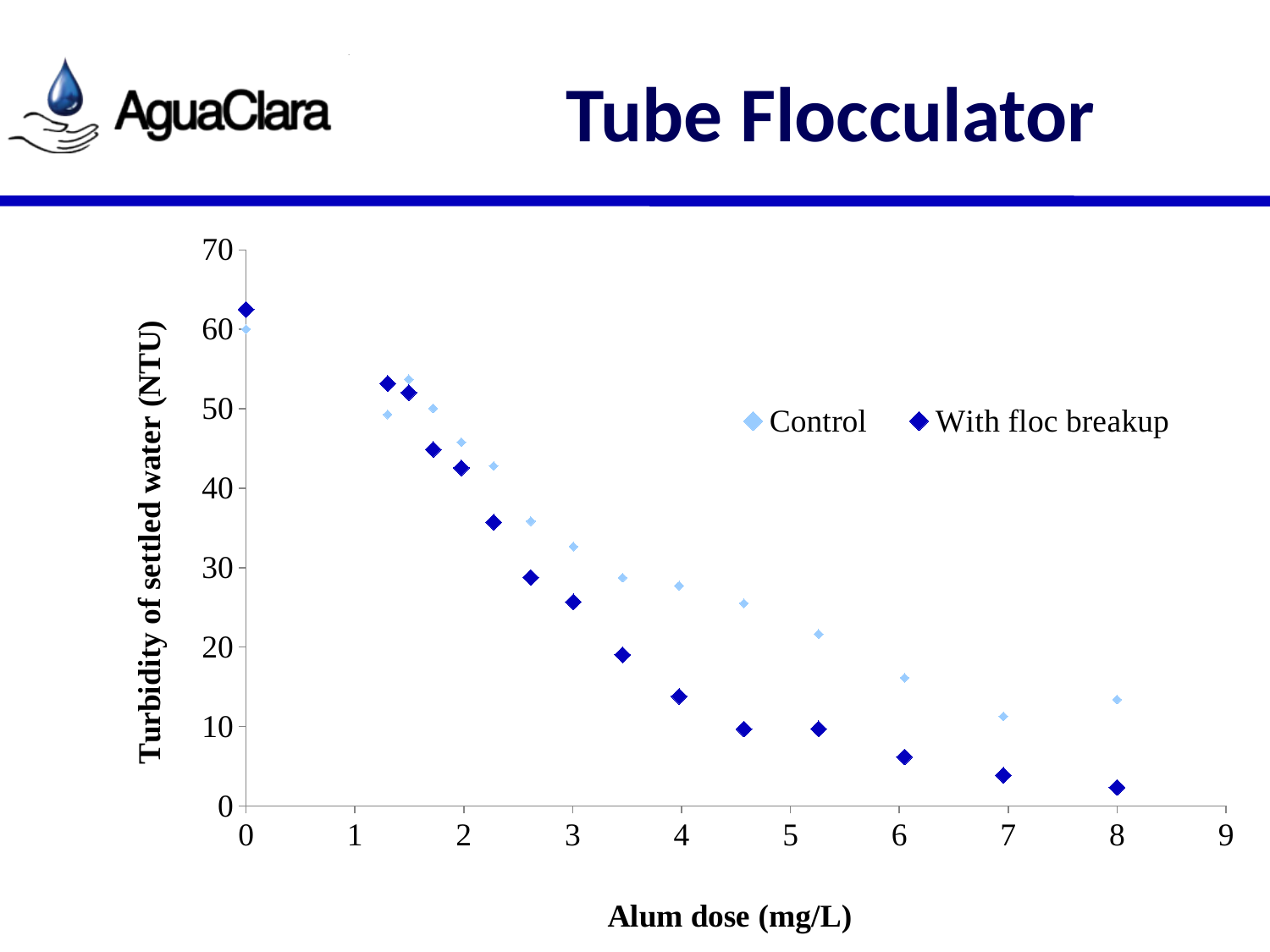
Does the turbidity of settled water rise or fall as the alum dose increases? fall Is the value for Control at an alum dose of 8 mg/L greater or less than 10? greater Is the value for With floc breakup at an alum dose of 0 mg/L greater or less than 50? greater What kind of chart is shown on the slide? scatter chart What is the title of the x axis? Alum dose (mg/L) What are the two series named in the legend? Control and With floc breakup Is the value for With floc breakup at an alum dose of 3 mg/L greater or less than 30? less At an alum dose of 8 mg/L, which series has the higher turbidity, Control or With floc breakup? Control How many series does the legend list? 2 At an alum dose of 4 mg/L, which series has the lower turbidity, Control or With floc breakup? With floc breakup